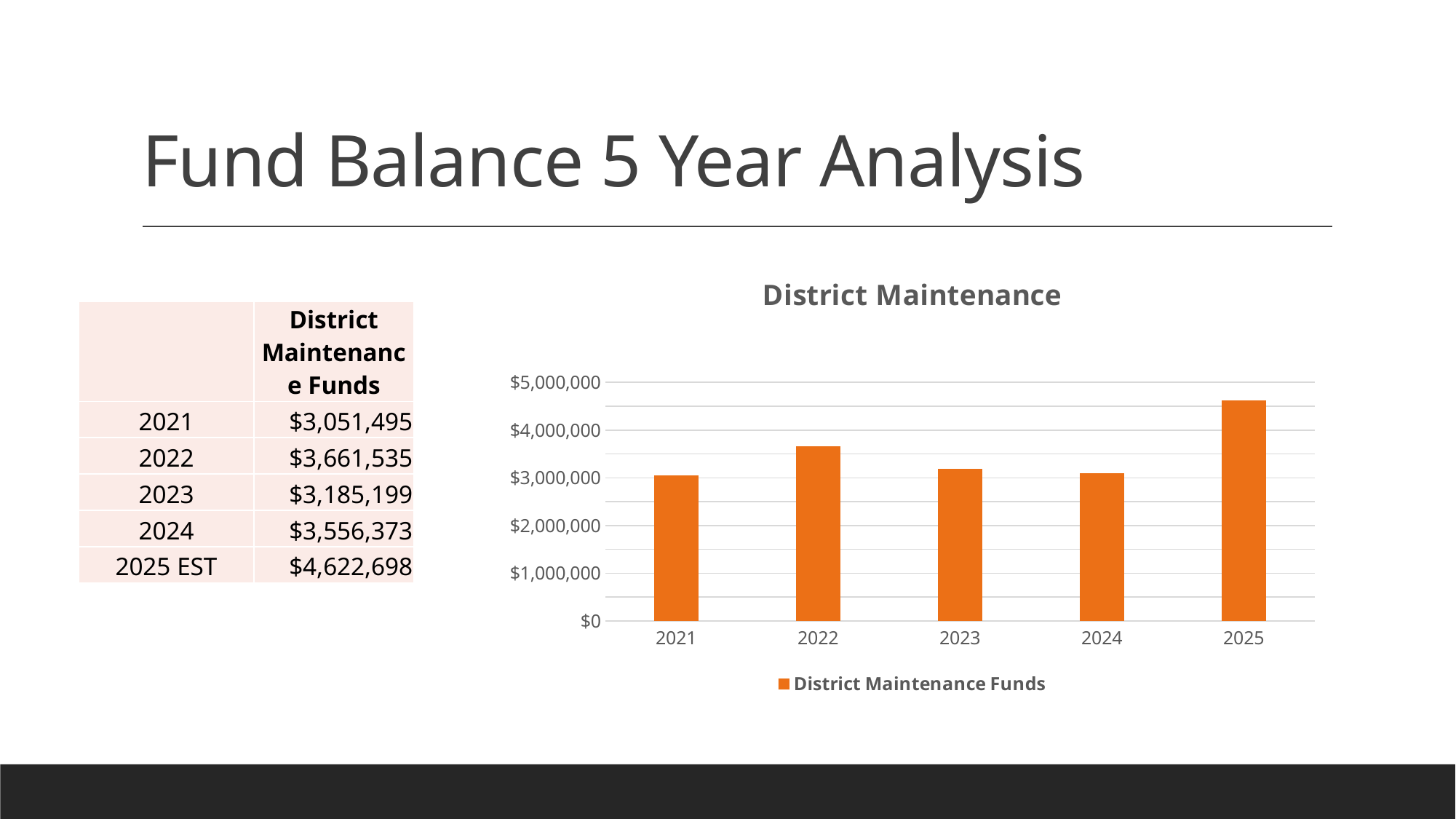
How many series does the chart legend list? 1 What is the District Maintenance Funds value for 2025? $4,622,698 What type of chart is shown on the slide? bar chart What is the title of the chart? District Maintenance Is the District Maintenance Funds value for 2023 greater or less than $4,000,000? less How many years are plotted on the x axis of the chart? 5 What is the difference between the District Maintenance Funds values for 2025 and 2021? $1,571,203 Which is larger, the District Maintenance Funds value for 2022 or for 2023? 2022 Is the District Maintenance Funds value for 2025 greater or less than $4,000,000? greater Which year has the highest District Maintenance Funds value? 2025 Which year has the lowest District Maintenance Funds value? 2021 What is the District Maintenance Funds value for 2022? $3,661,535